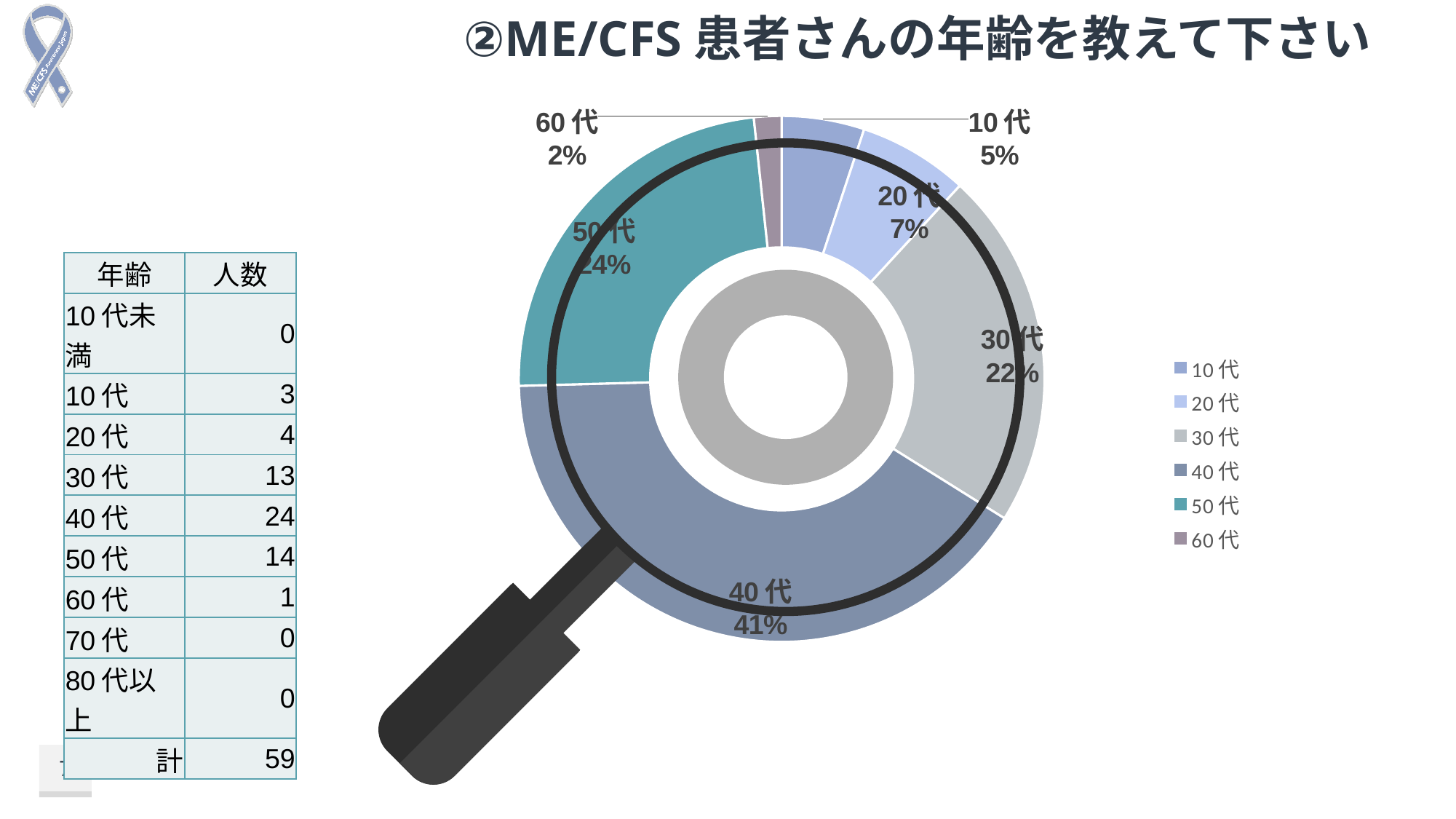
Which slice is larger, 20代 or 10代? 20代 Which age group has the largest slice of the chart? 40代 Which age group has the smallest slice of the chart? 60代 How many age groups are shown as slices in the chart? 6 What is the difference in percentage points between the 40代 slice and the 50代 slice? 17 What percentage is shown for the 30代 slice? 22% How many entries does the chart legend list? 6 What percentage is shown for the 60代 slice? 2% Which slice is larger, 50代 or 30代? 50代 What share of the pie does the 40代 slice represent? 41% What percentage is shown for the 10代 slice? 5% What kind of chart is shown on the slide? Pie (doughnut) chart